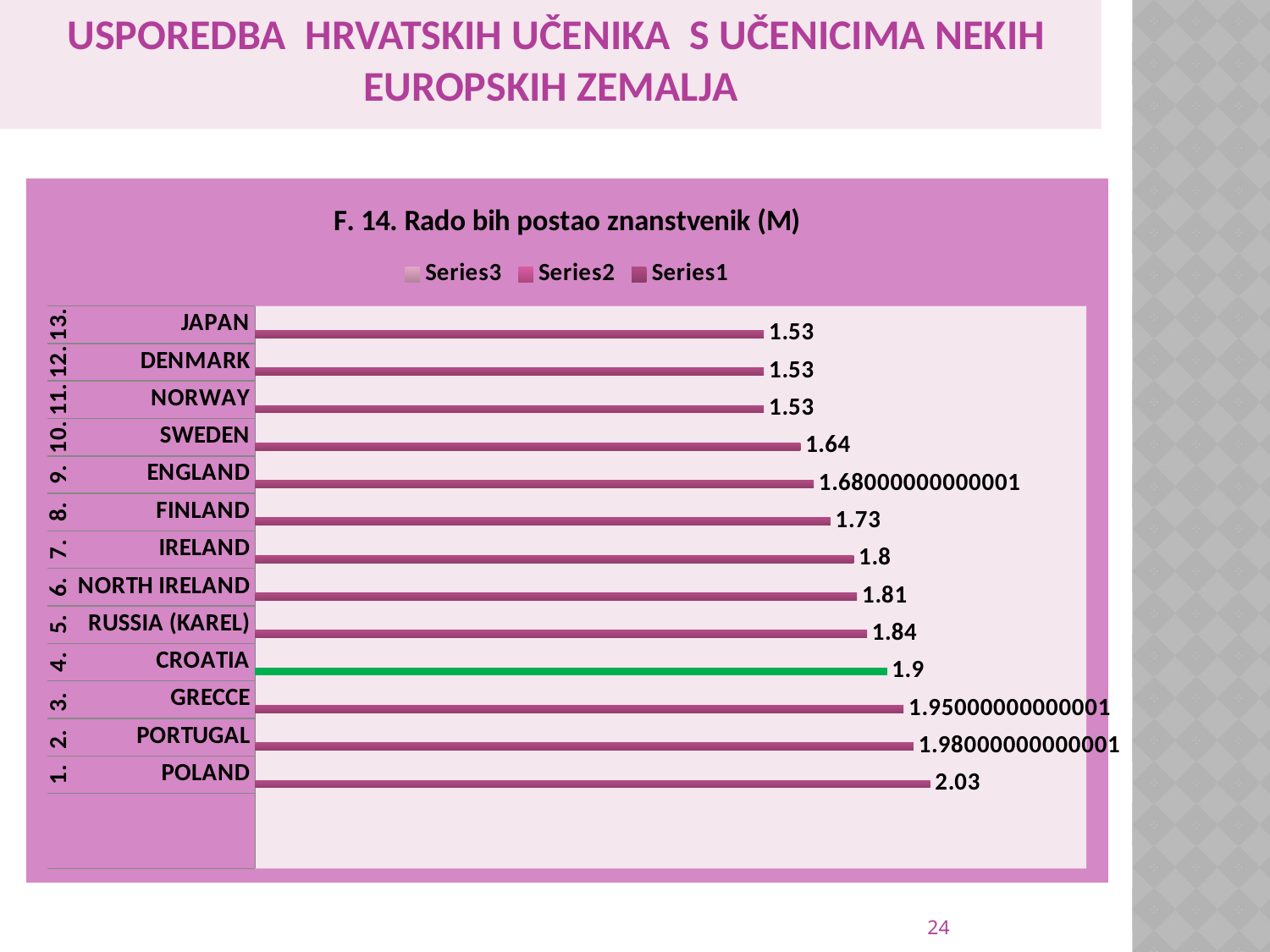
What is the value for FINLAND in the chart? 1.73 Which country has the highest value in the chart? POLAND What kind of chart is shown on the slide? Bar chart What is the value for POLAND in the chart? 2.03 What is the difference between the values for POLAND and CROATIA? 0.13 Which has a larger value, SWEDEN or FINLAND? FINLAND What value is printed next to the bar for ENGLAND? 1.68000000000001 Which country's bar is coloured green instead of purple? CROATIA What is the difference between the values for RUSSIA (KAREL) and IRELAND? 0.04 How many countries are shown in the chart? 13 How many series does the legend list? 3 What is the value for CROATIA in the chart? 1.9